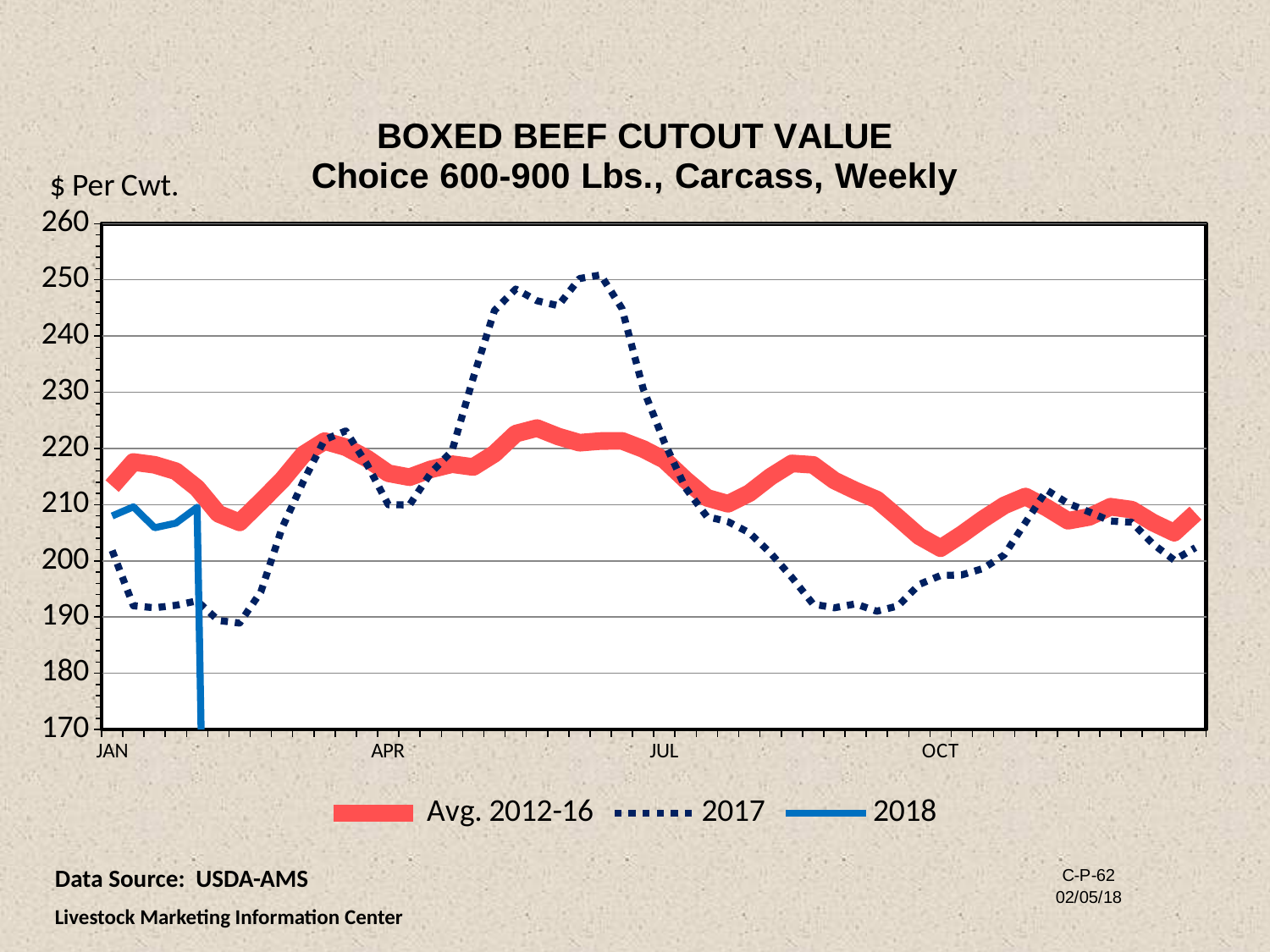
How many series does the legend list? 3 What kind of chart is shown on the slide? Line chart Does the 2017 series rise or fall between JUL and OCT? Fall What unit is shown on the vertical axis label? $ Per Cwt. Which series reaches the highest value on the chart? 2017 Around OCT, which series is higher: 2017 or Avg. 2012-16? Avg. 2012-16 Is the peak value of the 2017 series greater or less than 240? greater What is the title of the chart? BOXED BEEF CUTOUT VALUE Choice 600-900 Lbs., Carcass, Weekly Is the value of the Avg. 2012-16 series at the start of JAN greater or less than 210? greater Is the value of the 2017 series at the start of JAN greater or less than 210? less Around JUL, which series is higher: 2017 or Avg. 2012-16? 2017